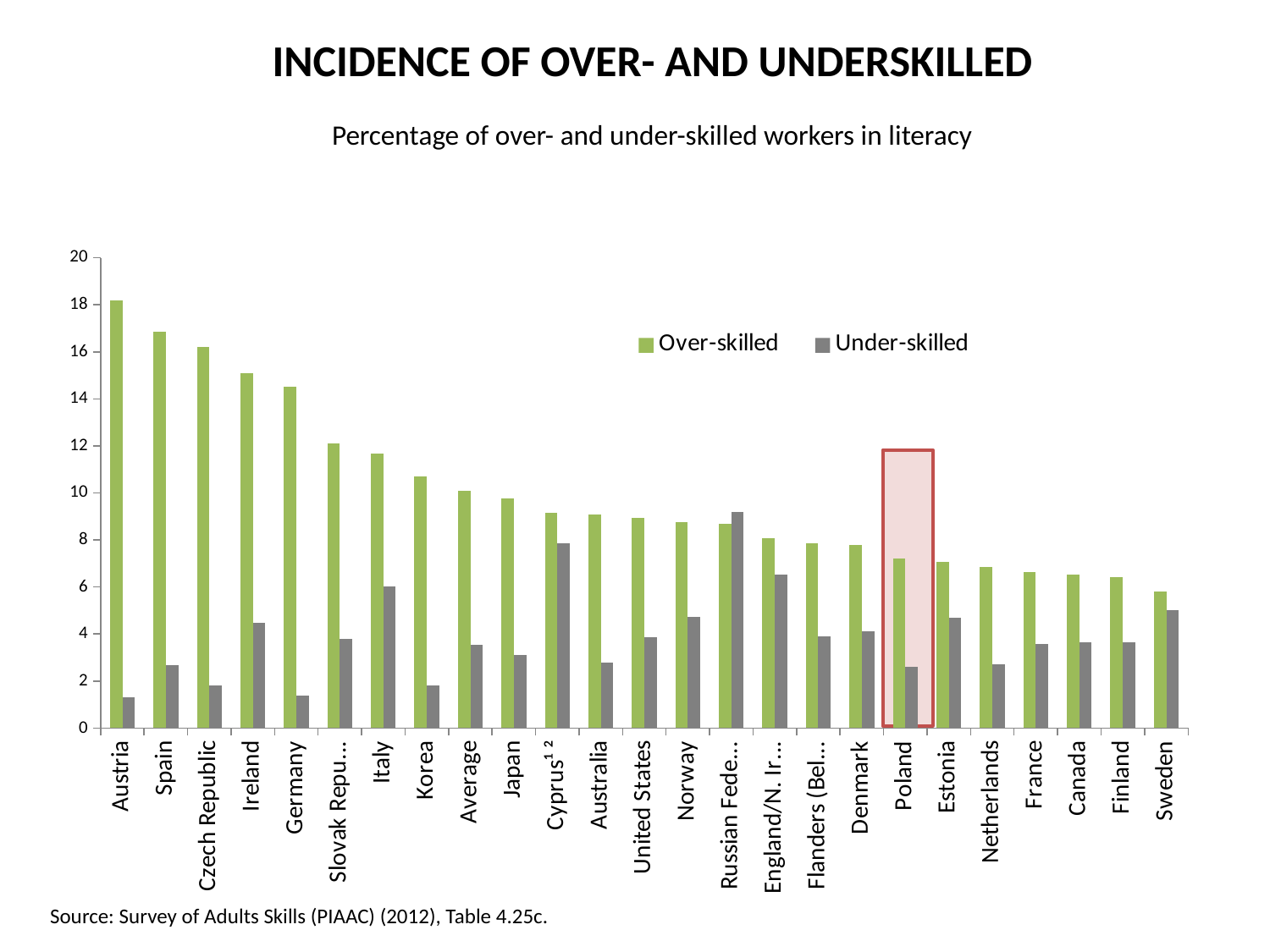
Which country has the lowest Over-skilled value? Sweden Is the Under-skilled value for Korea greater or less than 2? less Do the Over-skilled values rise or fall from left to right along the x axis? fall What kind of chart is shown on the slide? bar chart Is the Under-skilled value for Italy greater or less than 4? greater Which is larger, the Under-skilled value for Italy or for Korea? Italy Is the Over-skilled value for Poland greater or less than 8? less Which country is highlighted with a red box on the chart? Poland How many series does the legend list? 2 Which category has the highest Under-skilled value? Russian Fede... Which country has the highest Over-skilled value? Austria